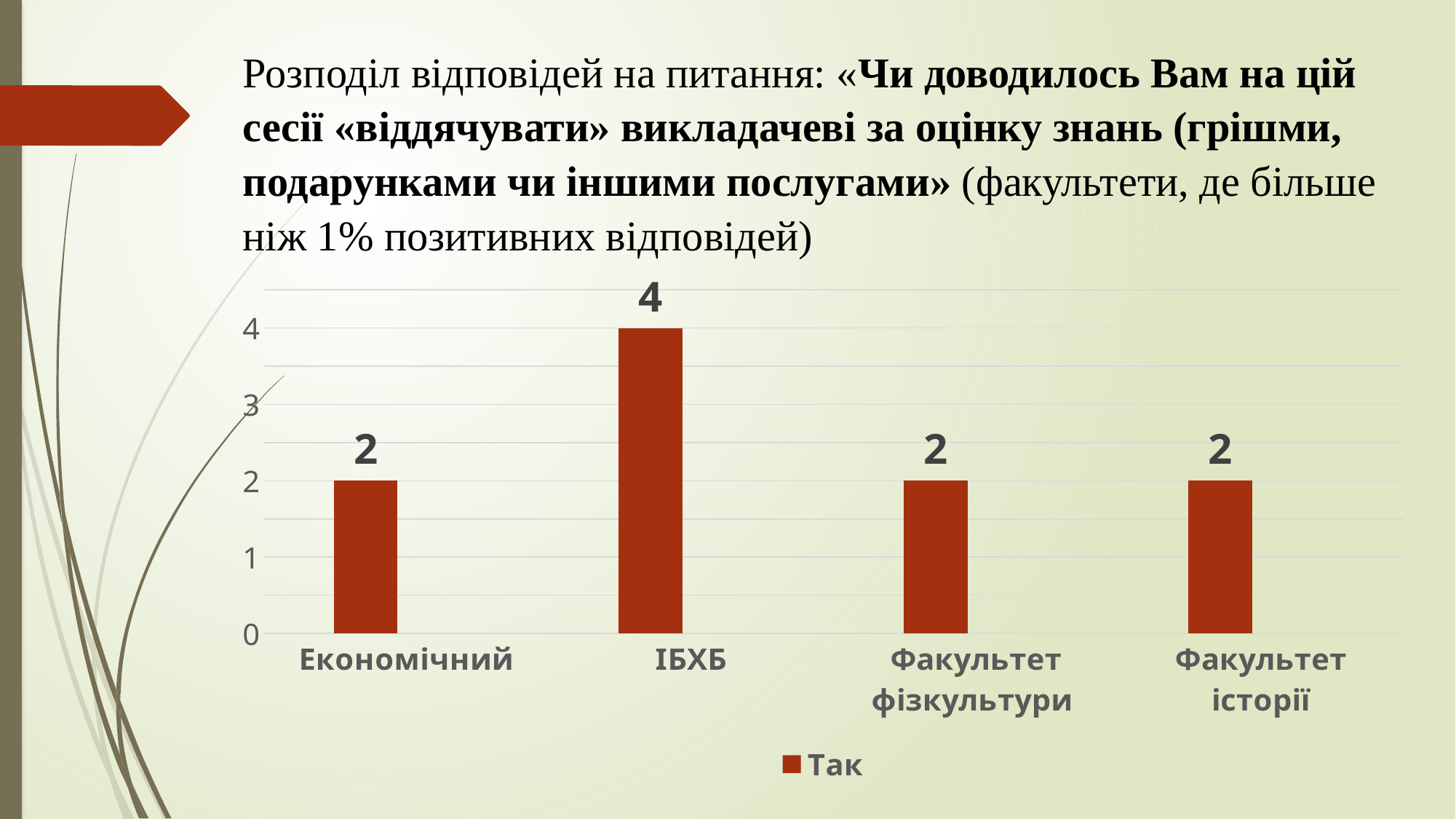
What is the value for ІБХБ? 4 Is the value for Факультет історії greater or less than 3? less Which category has the highest value? ІБХБ What kind of chart is shown on the slide? bar chart How many series does the legend list? 1 How many categories are shown on the x axis? 4 Which is larger, the value for ІБХБ or the value for Економічний? ІБХБ What is the value for Економічний? 2 What is the difference between the values for ІБХБ and Факультет фізкультури? 2 Is the value for ІБХБ greater or less than 3? greater What is the value for Факультет історії? 2 What is the legend entry for the series? Так